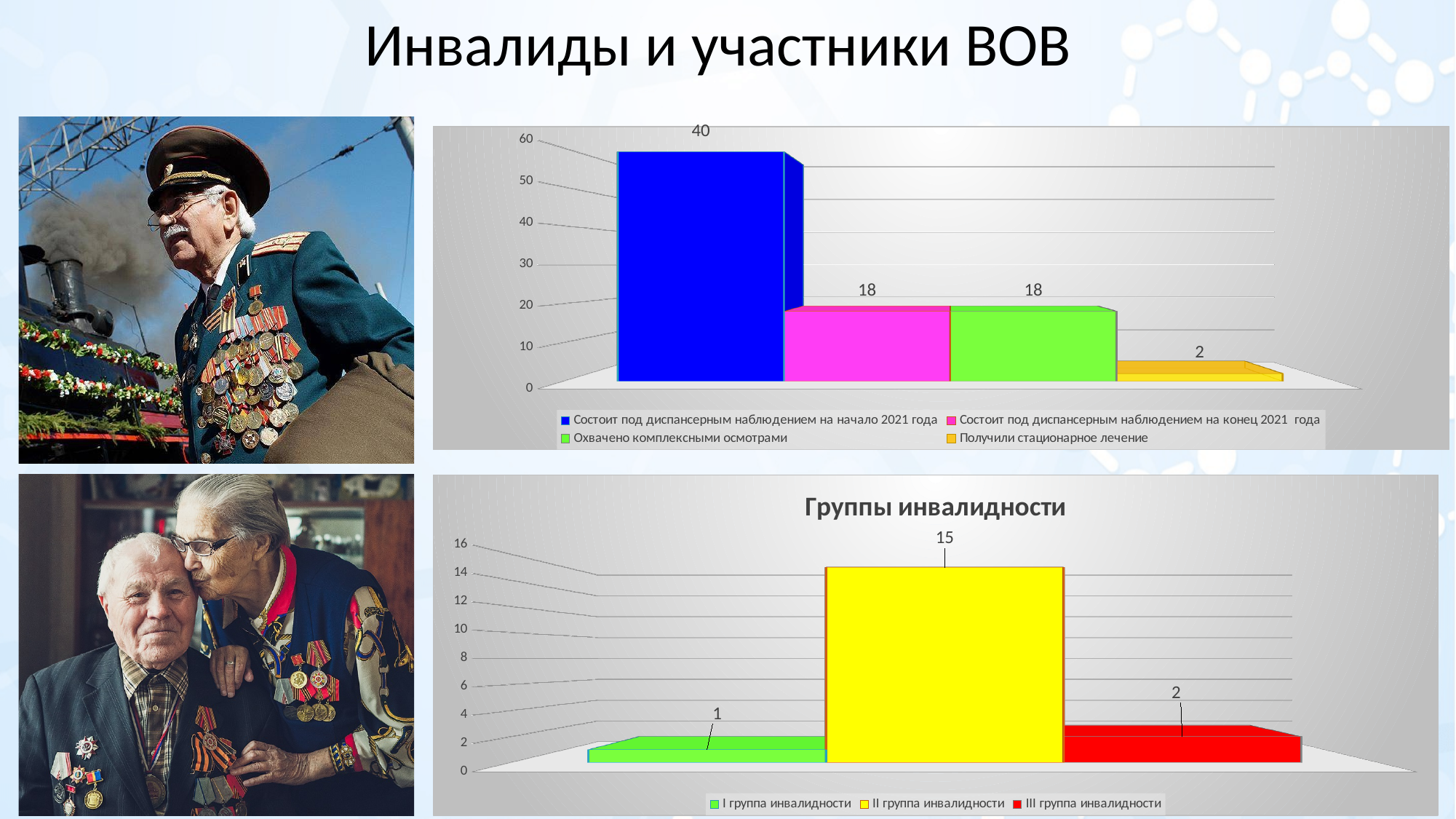
In the top chart, what is the value for 'Состоит под диспансерным наблюдением на начало 2021 года'? 40 In the chart titled 'Группы инвалидности', what is the difference between 'II группа инвалидности' and 'III группа инвалидности'? 13 In the chart titled 'Группы инвалидности', which category has the lowest value? I группа инвалидности In the top chart, what is the value for 'Получили стационарное лечение'? 2 In the top chart, what is the value for 'Охвачено комплексными осмотрами'? 18 In the chart titled 'Группы инвалидности', which is larger: 'III группа инвалидности' or 'I группа инвалидности'? III группа инвалидности In the top chart, what is the difference between 'Состоит под диспансерным наблюдением на начало 2021 года' and 'Состоит под диспансерным наблюдением на конец 2021 года'? 22 What kind of chart is the top chart? Bar chart How many entries does the legend of the top chart list? 4 What is the title of the bottom chart? Группы инвалидности In the top chart, which category has the highest value? Состоит под диспансерным наблюдением на начало 2021 года In the chart titled 'Группы инвалидности', what is the value for 'II группа инвалидности'? 15